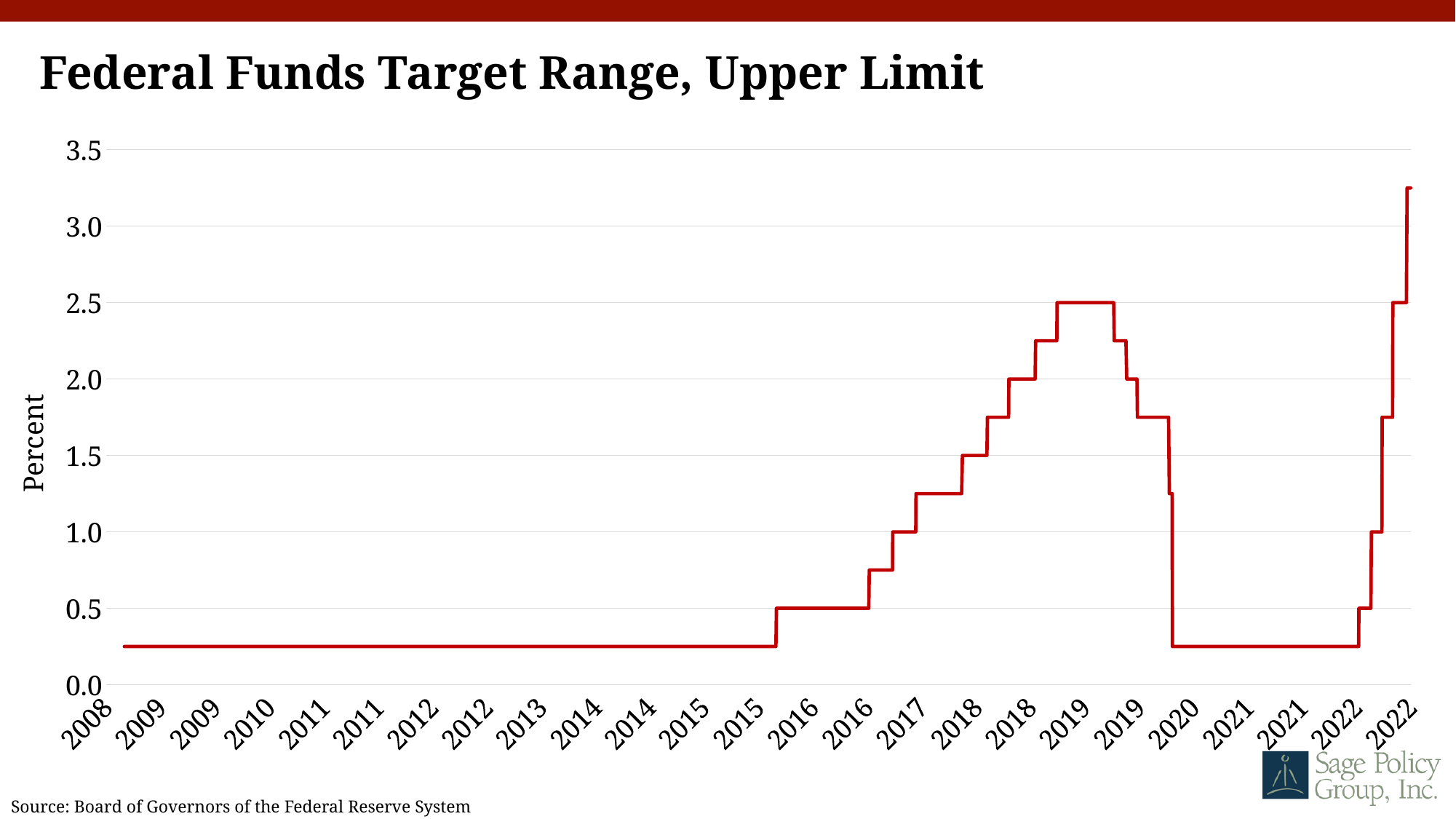
What kind of chart is shown on the slide? line chart Is the value of the line in early 2019 greater or less than 2.0? greater Does the line rise or fall between mid-2019 and 2020? fall Does the line rise or fall between 2016 and early 2019? rise Which is higher, the value of the line at the end of 2022 or the value at the 2019 plateau? end of 2022 What is the title of the chart? Federal Funds Target Range, Upper Limit Is the value of the line in 2010 greater or less than 0.5? less What is the label on the vertical axis of the chart? Percent Which is higher, the value of the line in 2019 or the value in 2021? 2019 Is the value of the line in 2021 greater or less than 1.0? less What value does the line reach at its plateau in 2019? 2.5